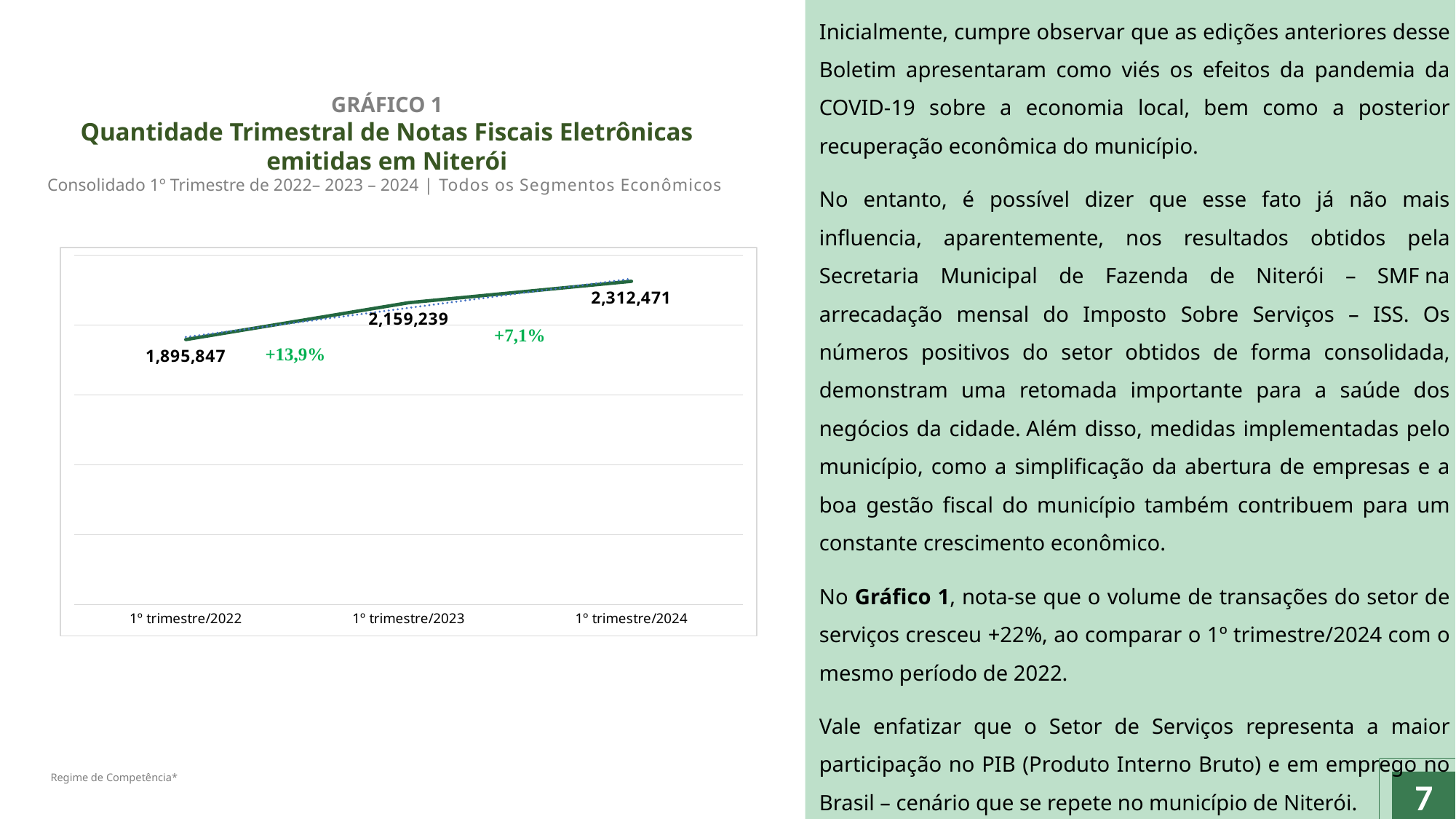
Do the values rise or fall from 1º trimestre/2022 to 1º trimestre/2024? Rise How many periods are plotted on the chart? 3 Which period has the lowest value? 1º trimestre/2022 What is the difference between the values for 1º trimestre/2023 and 1º trimestre/2022? 263,392 Which is larger, the value for 1º trimestre/2023 or 1º trimestre/2024? 1º trimestre/2024 What is the value for 1º trimestre/2023? 2,159,239 What is the value for 1º trimestre/2022? 1,895,847 What percentage change is annotated between 1º trimestre/2022 and 1º trimestre/2023? +13,9% What kind of chart is shown? Line chart What is the difference between the values for 1º trimestre/2024 and 1º trimestre/2023? 153,232 Which period has the highest value? 1º trimestre/2024 What is the value for 1º trimestre/2024? 2,312,471